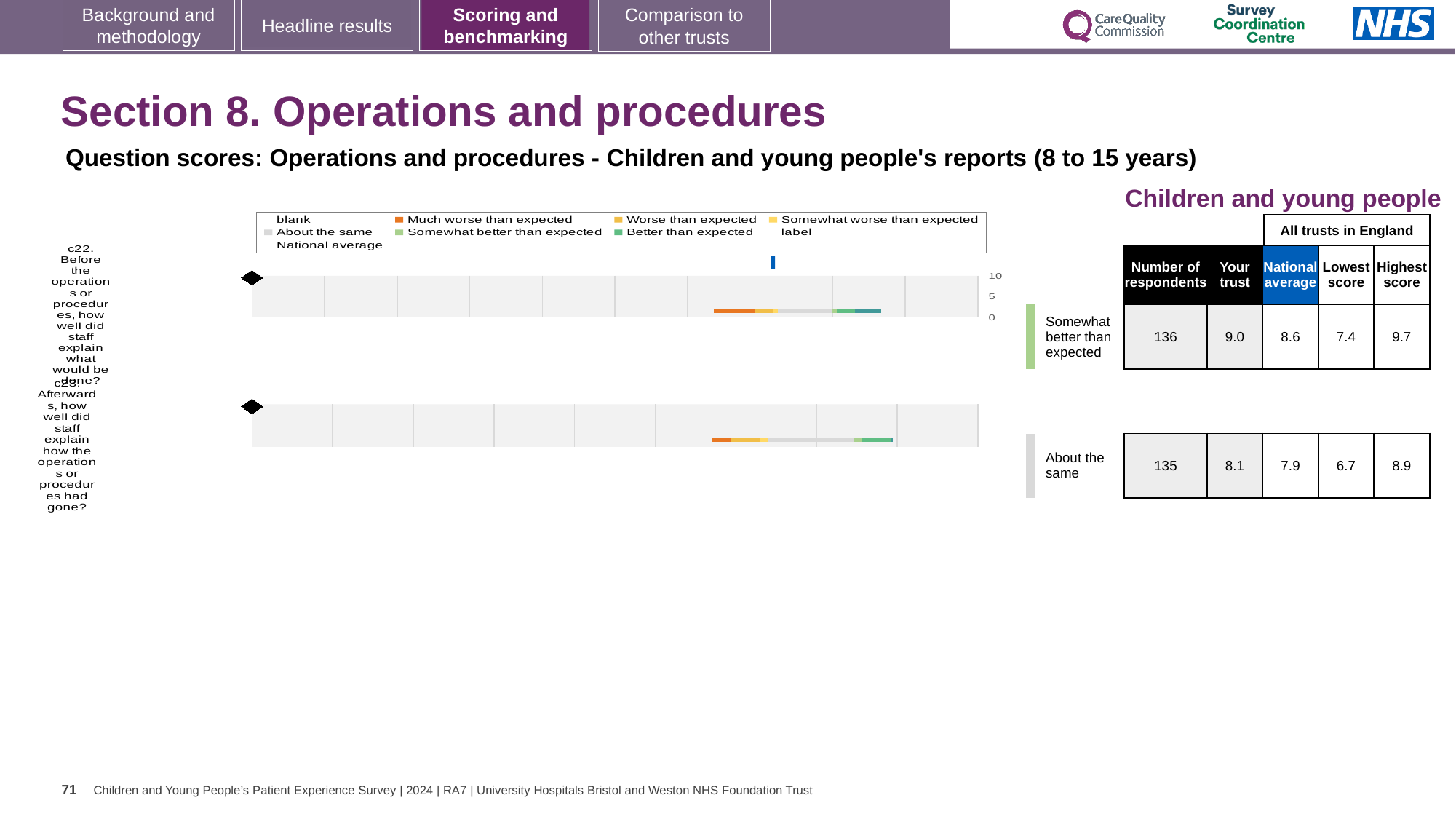
What is the difference between the highest and lowest scores across all trusts in England for question c23? 2.2 What is the highest score among all trusts in England for question c22? 9.7 Which benchmark category does the trust's score for question c22 fall into? Somewhat better than expected Which benchmark category does the trust's score for question c23 fall into? About the same What is the difference between the trust's score and the national average for question c22? 0.4 What kind of chart is used to show the question scores for c22 and c23? bar chart What colour does the legend use for 'Much worse than expected'? orange How many survey questions (categories) are plotted in the chart? 2 How many respondents answered question c22? 136 Which question has the higher 'Your trust' score, c22 or c23? c22 What is the national average score for question c23 (Afterwards, how well did staff explain how the operations or procedures had gone?)? 7.9 What is the 'Your trust' score for question c22 (Before the operations or procedures, how well did staff explain what would be done?)? 9.0